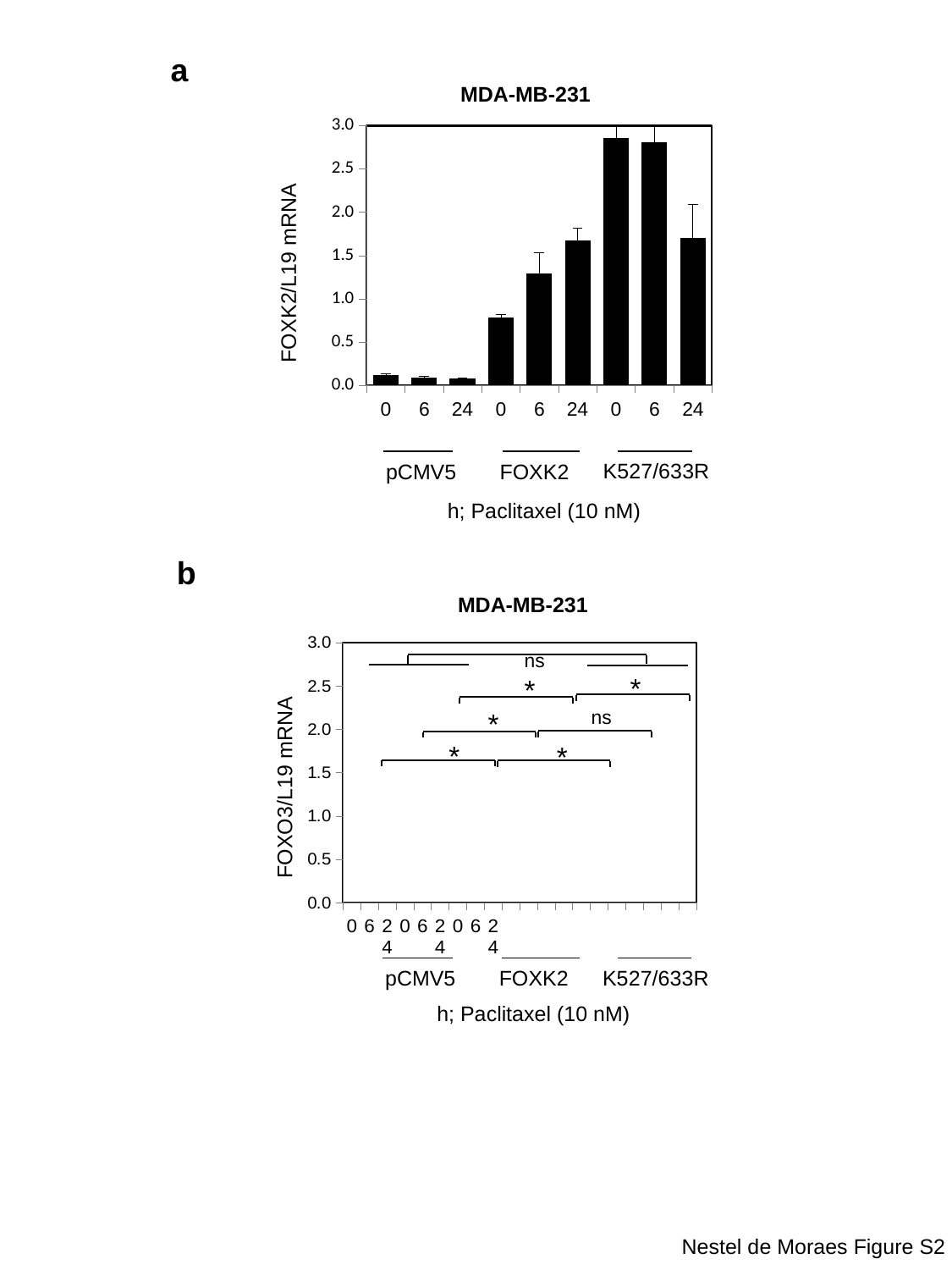
In panel a, what kind of chart is shown? bar chart In panel a, how many bars are plotted in total? 9 In panel a, what is the y-axis label? FOXK2/L19 mRNA In panel a, which treatment group contains the tallest bar? K527/633R In panel a, which is larger: the FOXK2 bar at 0 h or the FOXK2 bar at 24 h? FOXK2 at 24 h In panel a, do the FOXK2 bars rise or fall from 0 h to 24 h? rise In panel a, which treatment group has the lowest bars overall? pCMV5 In panel a, is the value for FOXK2 at 0 h greater or less than 1.0? less In panel a, is the value for K527/633R at 0 h greater or less than 2.5? greater In panel b, what is the y-axis label? FOXO3/L19 mRNA In panel a, is the value for FOXK2 at 24 h greater or less than 1.5? greater